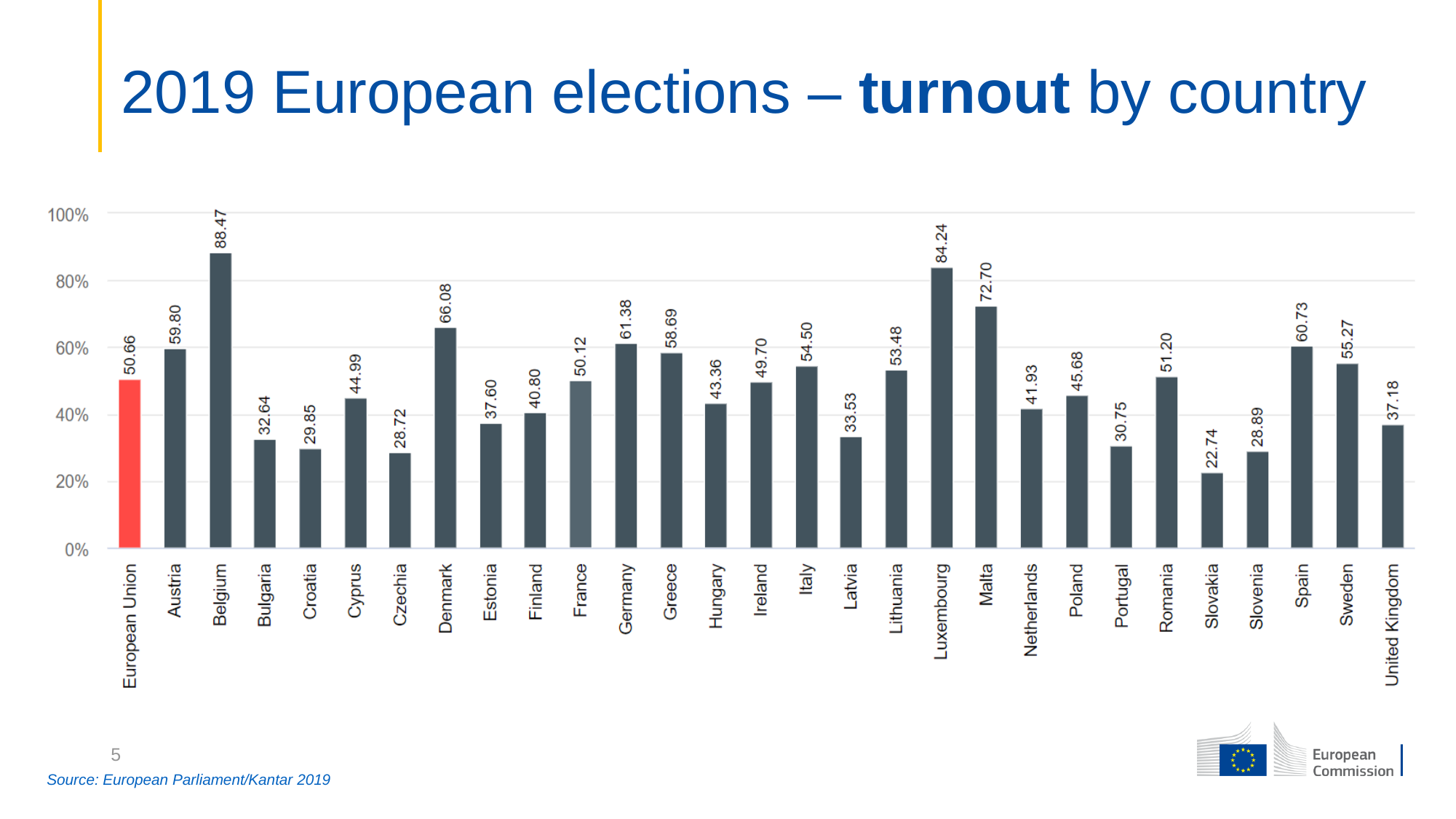
Is the turnout value for Italy greater or less than 60%? less What kind of chart is shown on the slide? Bar chart What is the difference between the turnout values for Luxembourg and Malta? 11.54 What is the turnout value shown for Slovenia? 28.89 Which bar in the chart is coloured red rather than dark grey? European Union What is the turnout value shown for the European Union bar? 50.66 How many bars (categories) are shown in the chart? 29 What is the difference between the turnout values for Belgium and Slovakia? 65.73 What is the turnout value shown for Germany? 61.38 Which country has the highest turnout in the chart? Belgium Which country has the lowest turnout in the chart? Slovakia Which has a higher turnout, Denmark or Spain? Denmark